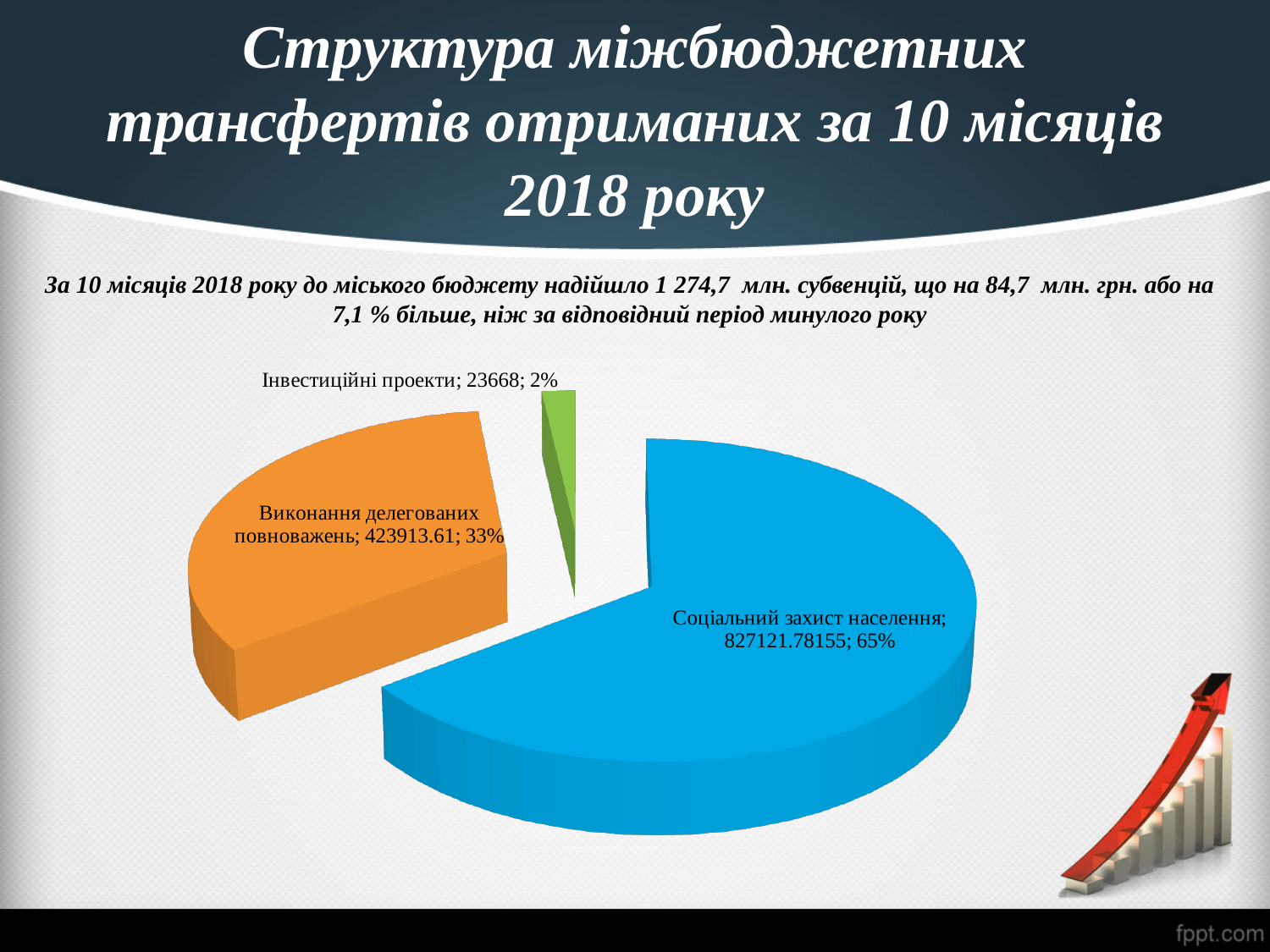
What kind of chart is shown on the slide? pie chart What is the value for Соціальний захист населення? 827121.78155 Which category has the largest slice? Соціальний захист населення What share of the pie does Виконання делегованих повноважень take? 33% Which category has the smallest slice? Інвестиційні проекти What is the value for Інвестиційні проекти? 23668 What colour is the slice for Соціальний захист населення? blue What share of the pie does Інвестиційні проекти take? 2% What share of the pie does Соціальний захист населення take? 65% How many slices does the pie chart have? 3 Which is larger, Виконання делегованих повноважень or Інвестиційні проекти? Виконання делегованих повноважень What is the value for Виконання делегованих повноважень? 423913.61